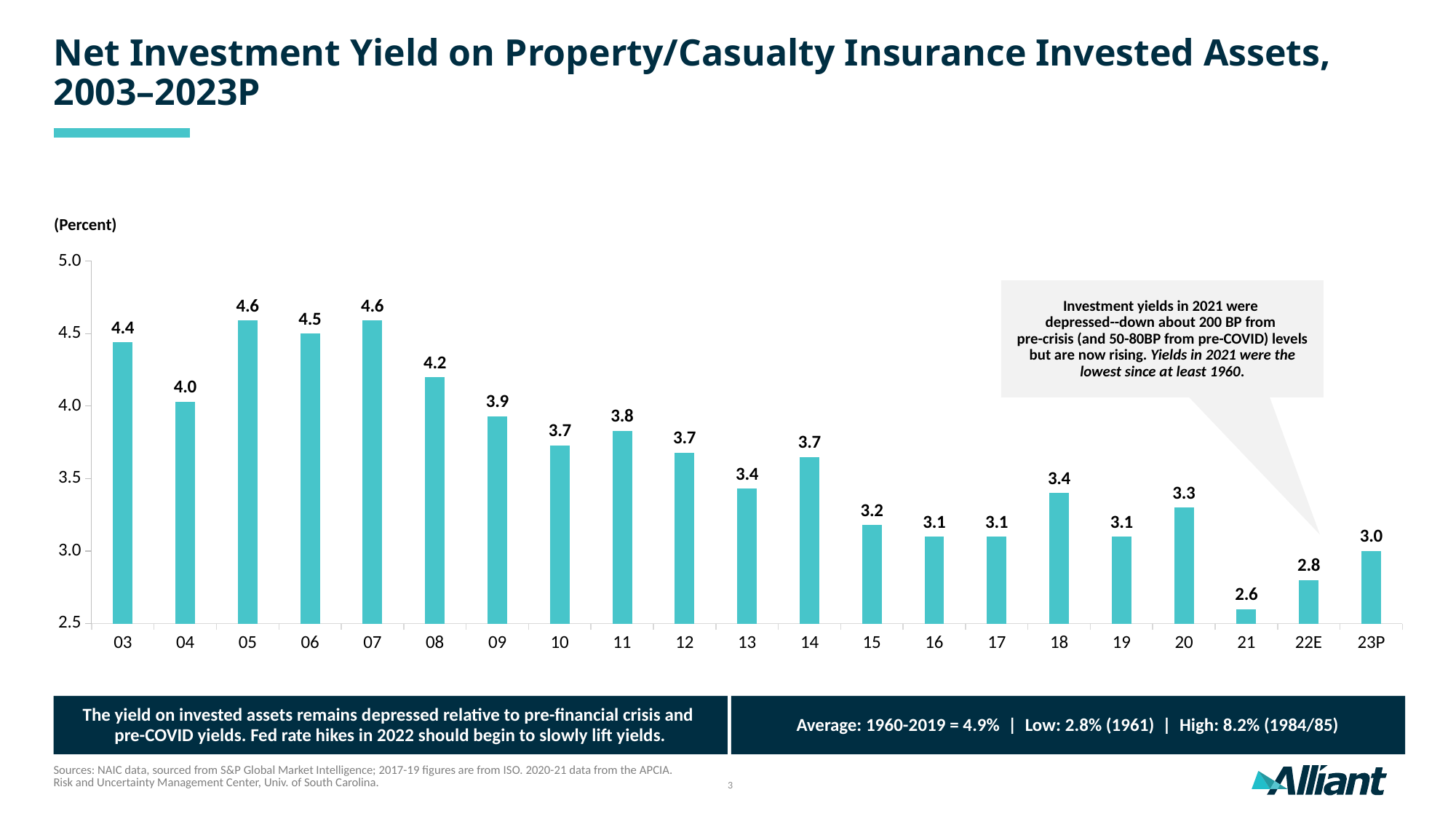
Which is larger, the yield in 18 or the yield in 19? 18 Is the value for 04 greater or less than 4.5? less Do the yields generally rise or fall from 07 to 21? fall What is the net investment yield for 2003? 4.4 Which year has the lowest net investment yield? 21 How many years are shown on the x axis? 21 What is the net investment yield for 21? 2.6 What is the net investment yield for 23P? 3.0 What is the net investment yield for 22E? 2.8 What unit is indicated above the y axis of the chart? Percent What is the difference between the yield in 08 and the yield in 21? 1.6 What kind of chart is shown on the slide? bar chart